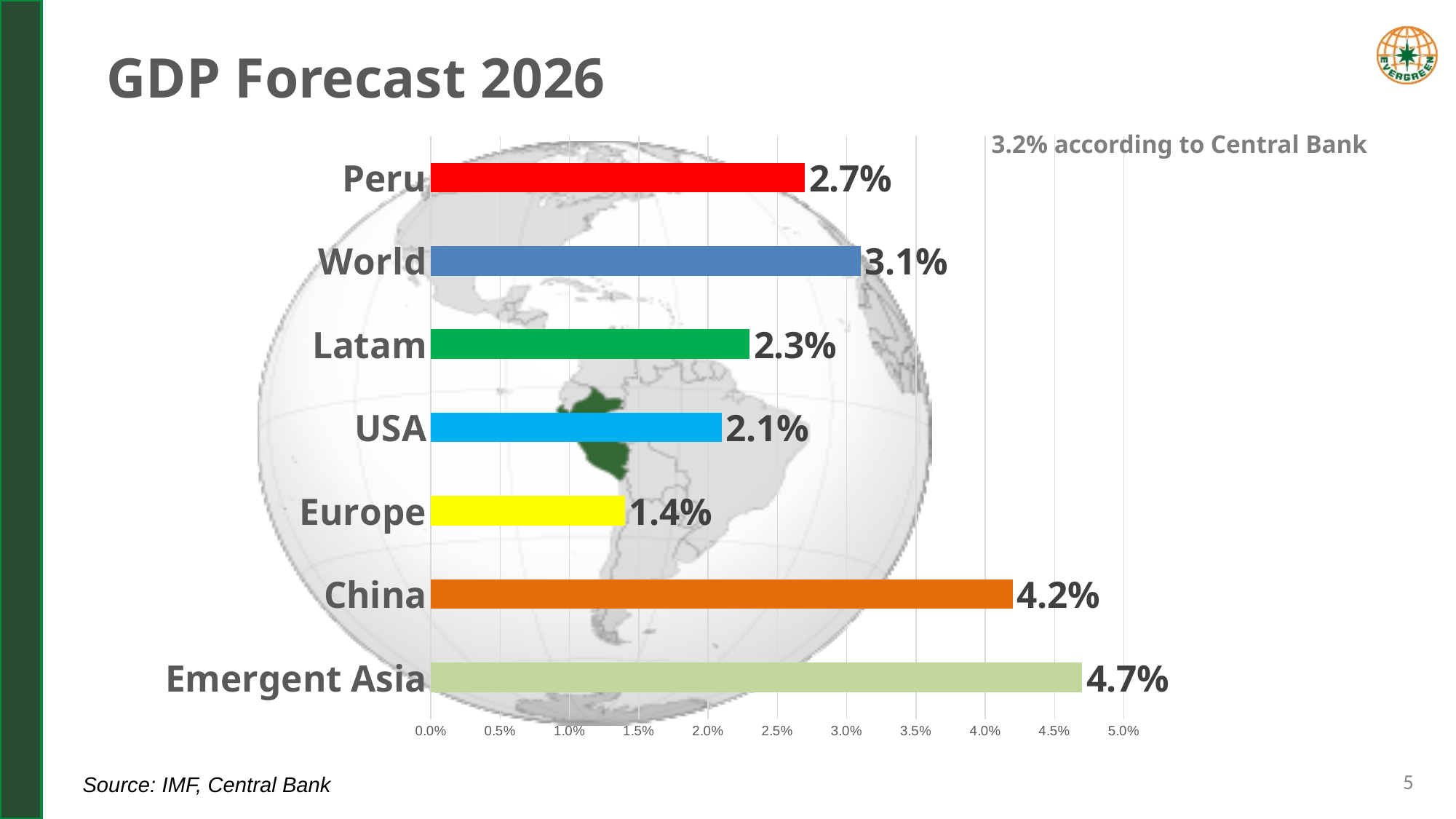
Which has a higher GDP forecast, Latam or USA? Latam What kind of chart is shown on the slide? Bar chart Which category has the lowest GDP forecast? Europe Which category has the highest GDP forecast? Emergent Asia What is the GDP forecast value for Europe? 1.4% What is the difference between the GDP forecast for World and for Peru? 0.4% What is the difference between the GDP forecast for Emergent Asia and for China? 0.5% What is the GDP forecast value for China? 4.2% Is the value for World greater or less than 3.0%? greater What is the GDP forecast value for Peru? 2.7% How many categories are shown in the chart? 7 According to the note on the chart, what is the Central Bank's forecast for Peru? 3.2%